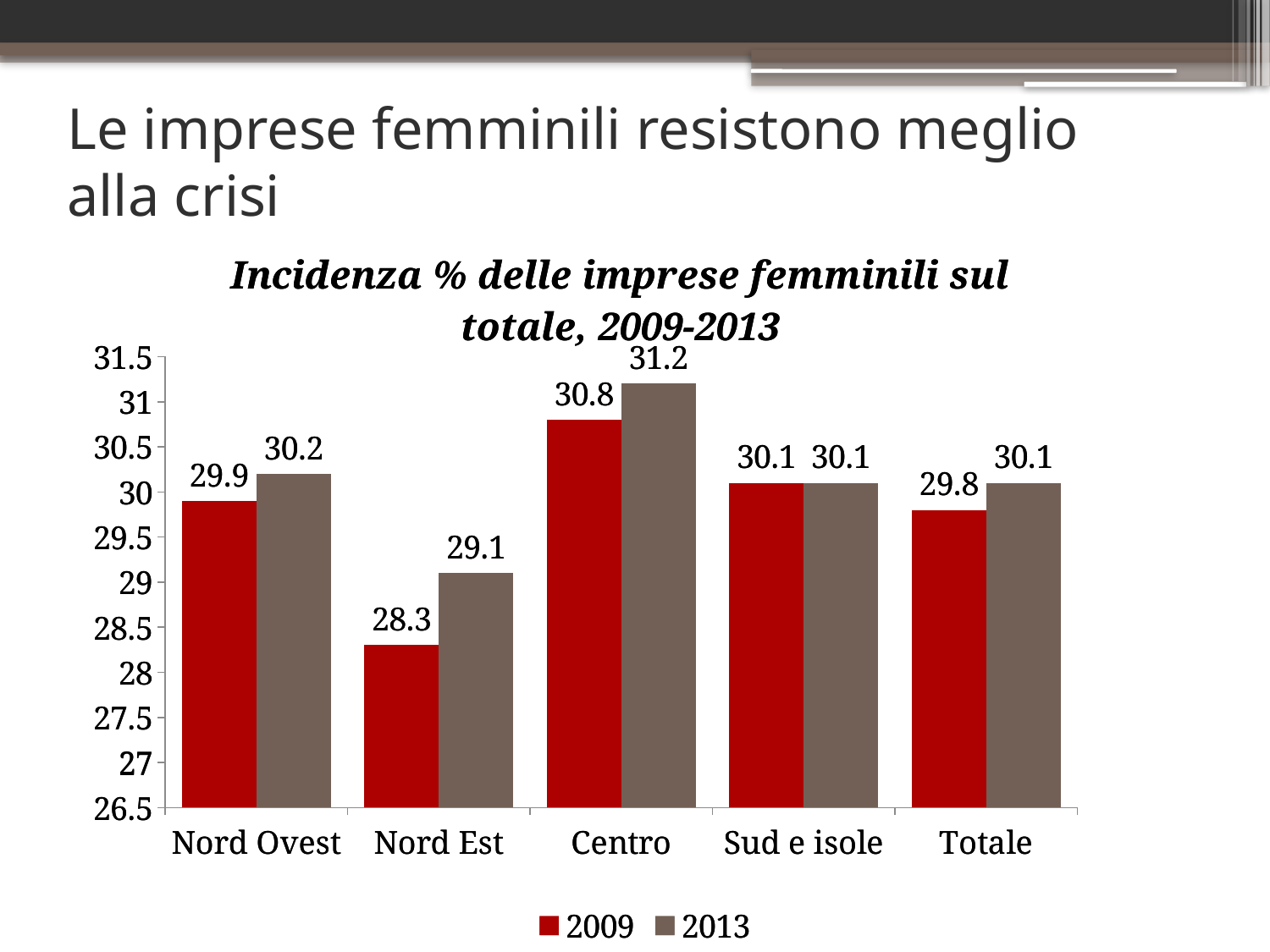
What is the value for Nord Est in 2009? 28.3 What is the value for Centro in 2013? 31.2 What is the title of the chart? Incidenza % delle imprese femminili sul totale, 2009-2013 What is the difference between the 2013 and 2009 values for Nord Est? 0.8 What kind of chart is shown on the slide? Bar chart How many series does the legend list? 2 What is the value for Nord Ovest in 2009? 29.9 Which category has the lowest value in 2009? Nord Est Which category has the highest value in 2013? Centro What is the value for Totale in 2013? 30.1 How many categories are shown on the x axis? 5 Which is larger for Centro, the 2009 value or the 2013 value? 2013